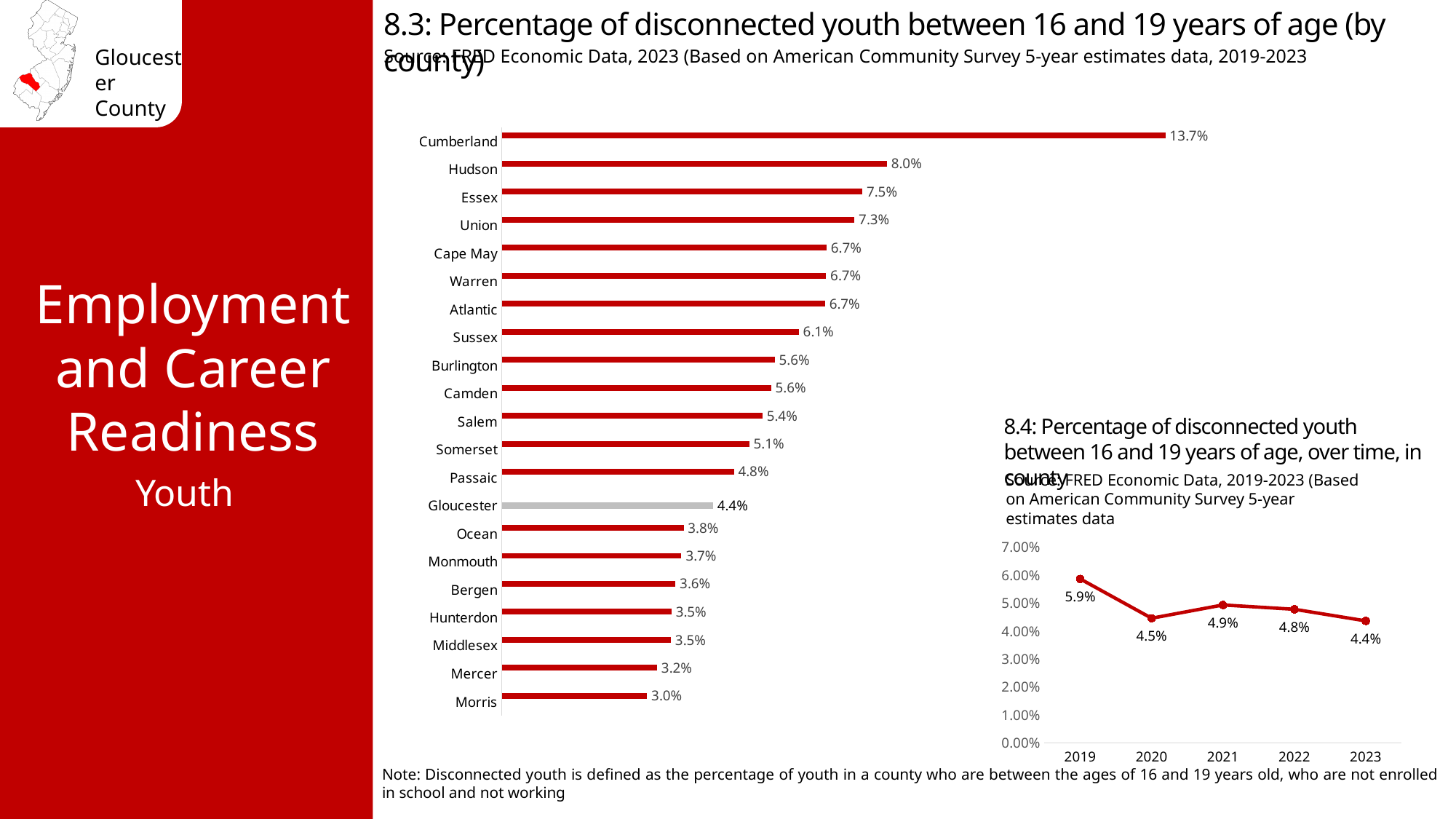
What kind of chart is the 8.3 chart (by county)? Bar chart In the 8.3 bar chart (by county), what is the difference between Cumberland and Hudson? 5.7% In the 8.4 line chart (over time), which year has the lowest value? 2023 In the 8.3 bar chart (by county), which is larger, the value for Essex or the value for Union? Essex In the 8.3 bar chart (by county), which county has the lowest percentage of disconnected youth? Morris In the 8.3 bar chart (by county), how many counties are shown? 21 In the 8.3 bar chart (by county), what is the value for Hudson? 8.0% In the 8.3 bar chart (by county), which bar is shown in grey rather than red? Gloucester In the 8.4 line chart (over time), what is the value for 2019? 5.9% In the 8.3 bar chart (by county), what is the value for Gloucester? 4.4% In the 8.4 line chart (over time), what is the difference between the 2019 and 2020 values? 1.4% In the 8.3 bar chart (by county), which county has the highest percentage of disconnected youth? Cumberland